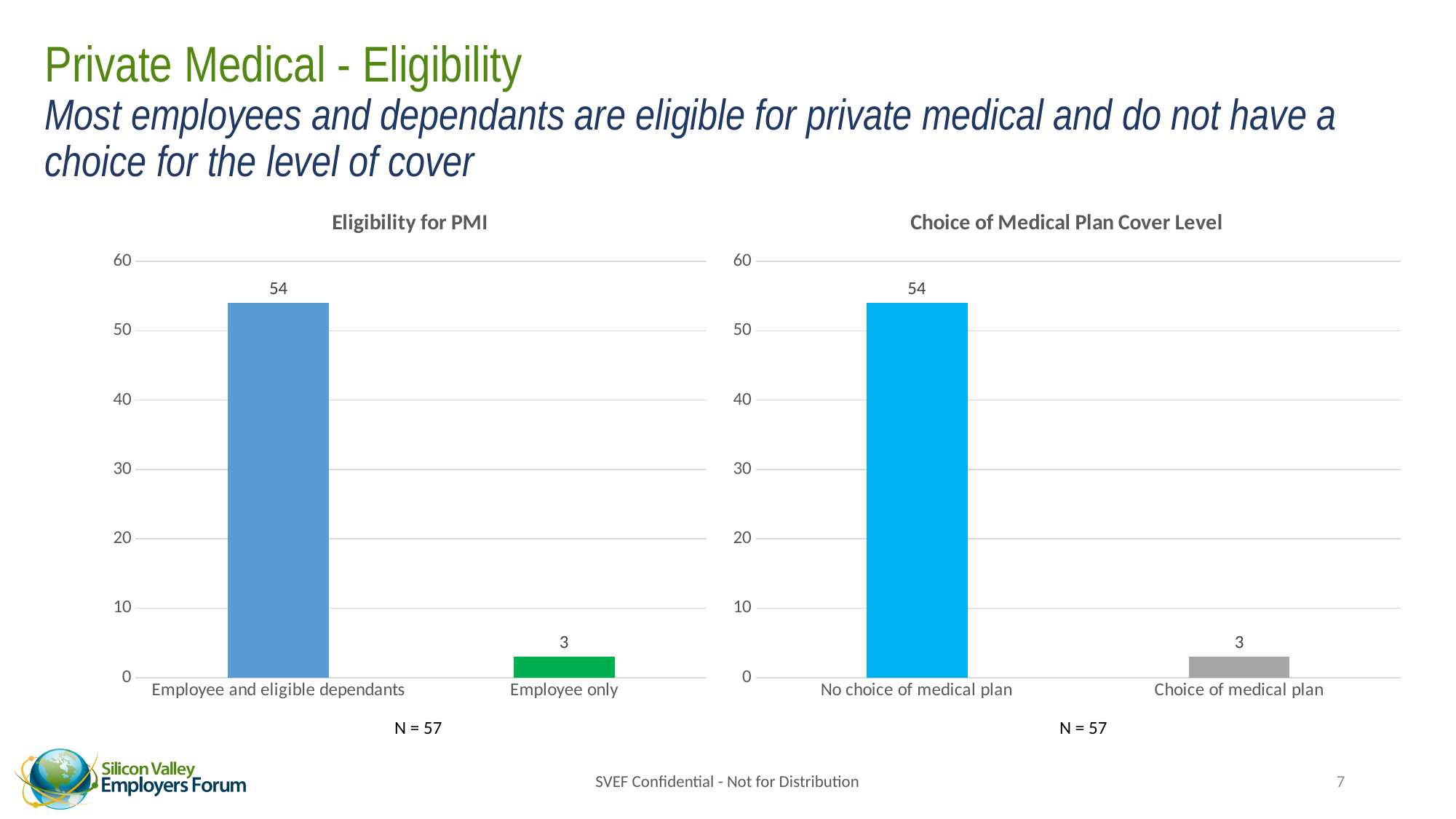
What sample size (N) is shown below the 'Choice of Medical Plan Cover Level' chart? N = 57 In the 'Eligibility for PMI' chart, is the value for 'Employee and eligible dependants' greater or less than 50? greater In the 'Eligibility for PMI' chart, what is the value for 'Employee and eligible dependants'? 54 In the 'Choice of Medical Plan Cover Level' chart, which is larger: 'No choice of medical plan' or 'Choice of medical plan'? No choice of medical plan In the 'Eligibility for PMI' chart, what is the difference between 'Employee and eligible dependants' and 'Employee only'? 51 In the 'Choice of Medical Plan Cover Level' chart, which category has the lowest value? Choice of medical plan What kind of chart is the 'Eligibility for PMI' chart? bar chart How many categories are shown in the 'Choice of Medical Plan Cover Level' chart? 2 In the 'Eligibility for PMI' chart, what is the value for 'Employee only'? 3 In the 'Eligibility for PMI' chart, which category has the highest value? Employee and eligible dependants In the 'Choice of Medical Plan Cover Level' chart, what is the value for 'No choice of medical plan'? 54 In the 'Choice of Medical Plan Cover Level' chart, what is the value for 'Choice of medical plan'? 3